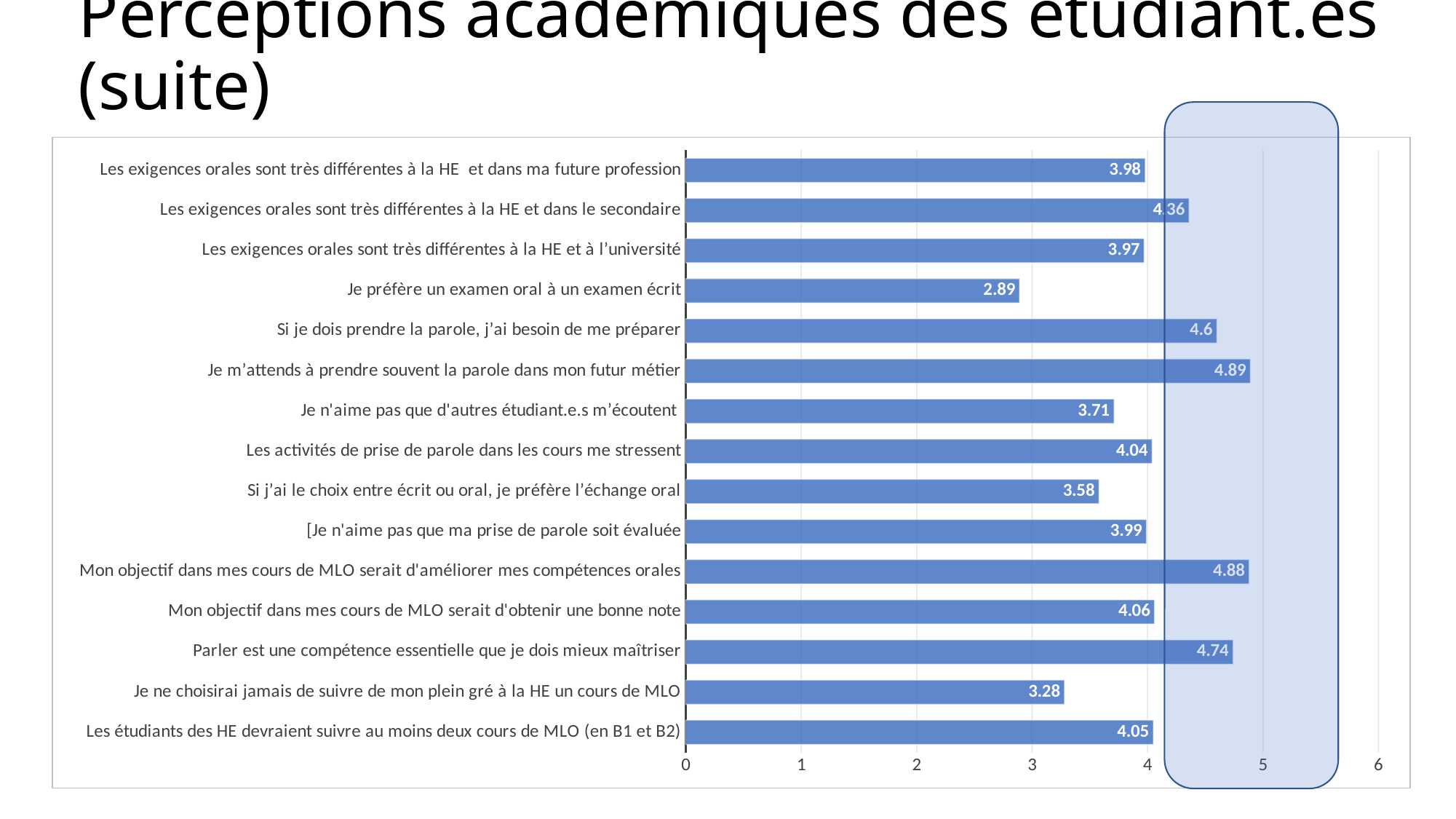
Which is larger: the value for "Si je dois prendre la parole, j'ai besoin de me préparer" or for "Je ne choisirai jamais de suivre de mon plein gré à la HE un cours de MLO"? Si je dois prendre la parole, j'ai besoin de me préparer What kind of chart is shown on the slide? bar chart What is the value for "Si je dois prendre la parole, j'ai besoin de me préparer"? 4.6 What is the value for "Je ne choisirai jamais de suivre de mon plein gré à la HE un cours de MLO"? 3.28 What is the value for "Parler est une compétence essentielle que je dois mieux maîtriser"? 4.74 How many statements (bars) are shown in the chart? 15 What is the highest value shown on the horizontal axis? 6 Is the value for "Je n'aime pas que d'autres étudiant.e.s m'écoutent" greater or less than 4? less What is the difference between the values for "Je m'attends à prendre souvent la parole dans mon futur métier" and "Je préfère un examen oral à un examen écrit"? 2 What is the value for "Les exigences orales sont très différentes à la HE et dans le secondaire"? 4.36 Which statement has the lowest value? Je préfère un examen oral à un examen écrit What is the value for "Je préfère un examen oral à un examen écrit"? 2.89